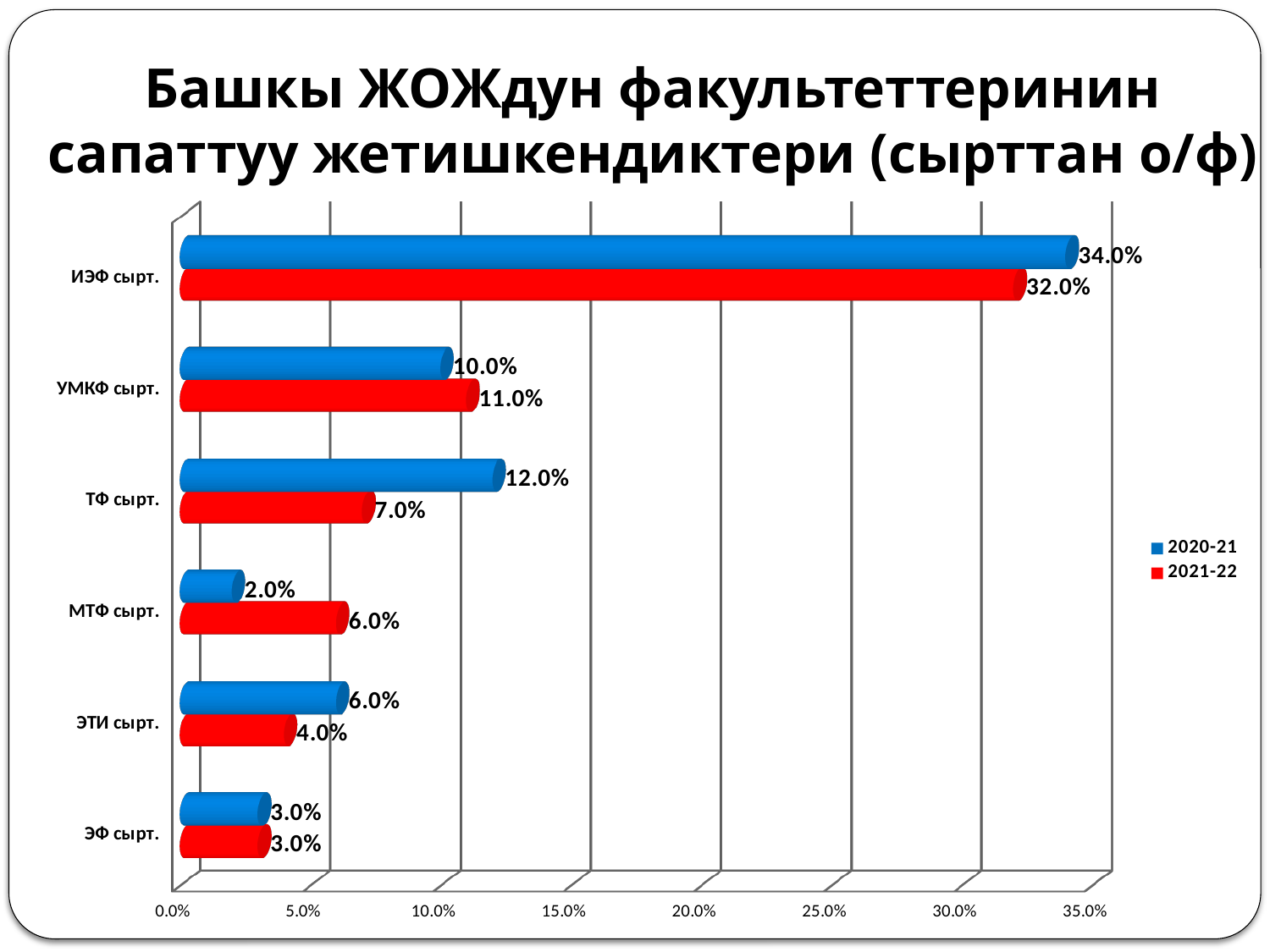
Which category has the lowest value in the 2020-21 series? МТФ сырт. What is the value for МТФ сырт. in the 2020-21 series? 2.0% What is the difference between the 2020-21 and 2021-22 values for ТФ сырт.? 5.0% What kind of chart is shown on the slide? Bar chart How many series does the legend list? 2 Is the 2021-22 value for ИЭФ сырт. greater or less than 30.0%? greater How many categories are shown on the chart? 6 What is the value for ИЭФ сырт. in the 2020-21 series? 34.0% What is the value for ТФ сырт. in the 2021-22 series? 7.0% What is the difference between the 2020-21 and 2021-22 values for ИЭФ сырт.? 2.0% Which category has the highest value in the 2021-22 series? ИЭФ сырт. Which is larger for УМКФ сырт.: the 2020-21 value or the 2021-22 value? 2021-22